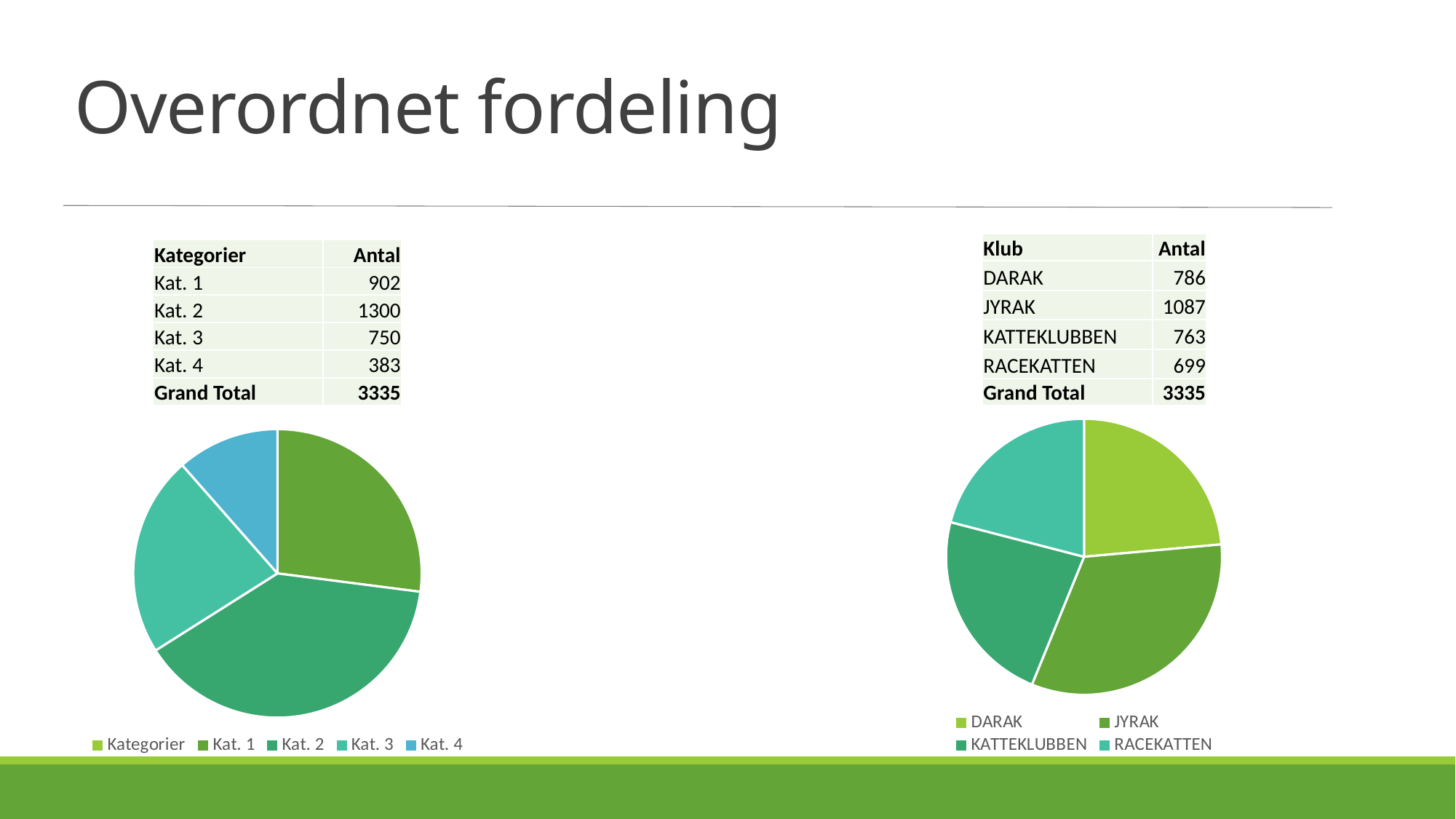
On the left pie chart (Kategorier), how many slices does the pie have? 4 On the right pie chart (Klub), which is larger, DARAK or KATTEKLUBBEN? DARAK On the right pie chart (Klub), what is the difference between the values for JYRAK and DARAK? 301 On the right pie chart (Klub), which club has the largest slice? JYRAK On the right pie chart (Klub), what is the value for RACEKATTEN? 699 What kind of chart is shown on the right side of the slide? Pie chart On the left pie chart (Kategorier), which category has the largest slice? Kat. 2 On the left pie chart (Kategorier), what is the value for Kat. 4? 383 On the right pie chart (Klub), what is the value for JYRAK? 1087 On the left pie chart (Kategorier), what is the value for Kat. 2? 1300 On the left pie chart (Kategorier), which category has the smallest slice? Kat. 4 On the left pie chart (Kategorier), what is the difference between the values for Kat. 2 and Kat. 1? 398